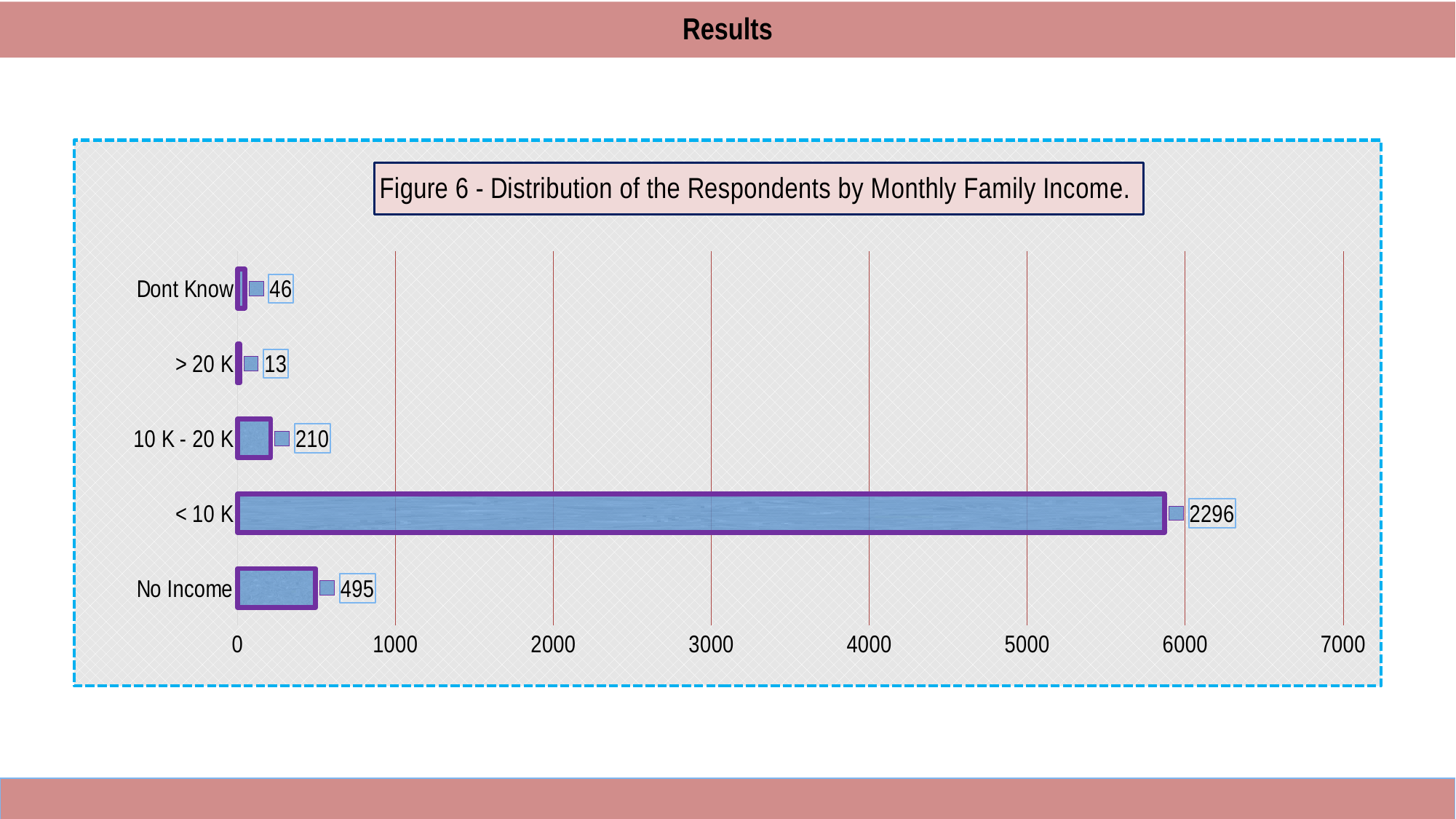
How many categories are shown in the chart? 5 What kind of chart is shown on the slide? Bar chart What is the value for the '10 K - 20 K' category? 210 Which category has the highest value? < 10 K Which category has the lowest value? > 20 K What is the value for the '> 20 K' category? 13 What is the difference between the values for 'No Income' and '10 K - 20 K'? 285 What is the value for the 'No Income' category? 495 What is the value for the 'Dont Know' category? 46 Which is larger, the value for 'Dont Know' or the value for '> 20 K'? Dont Know